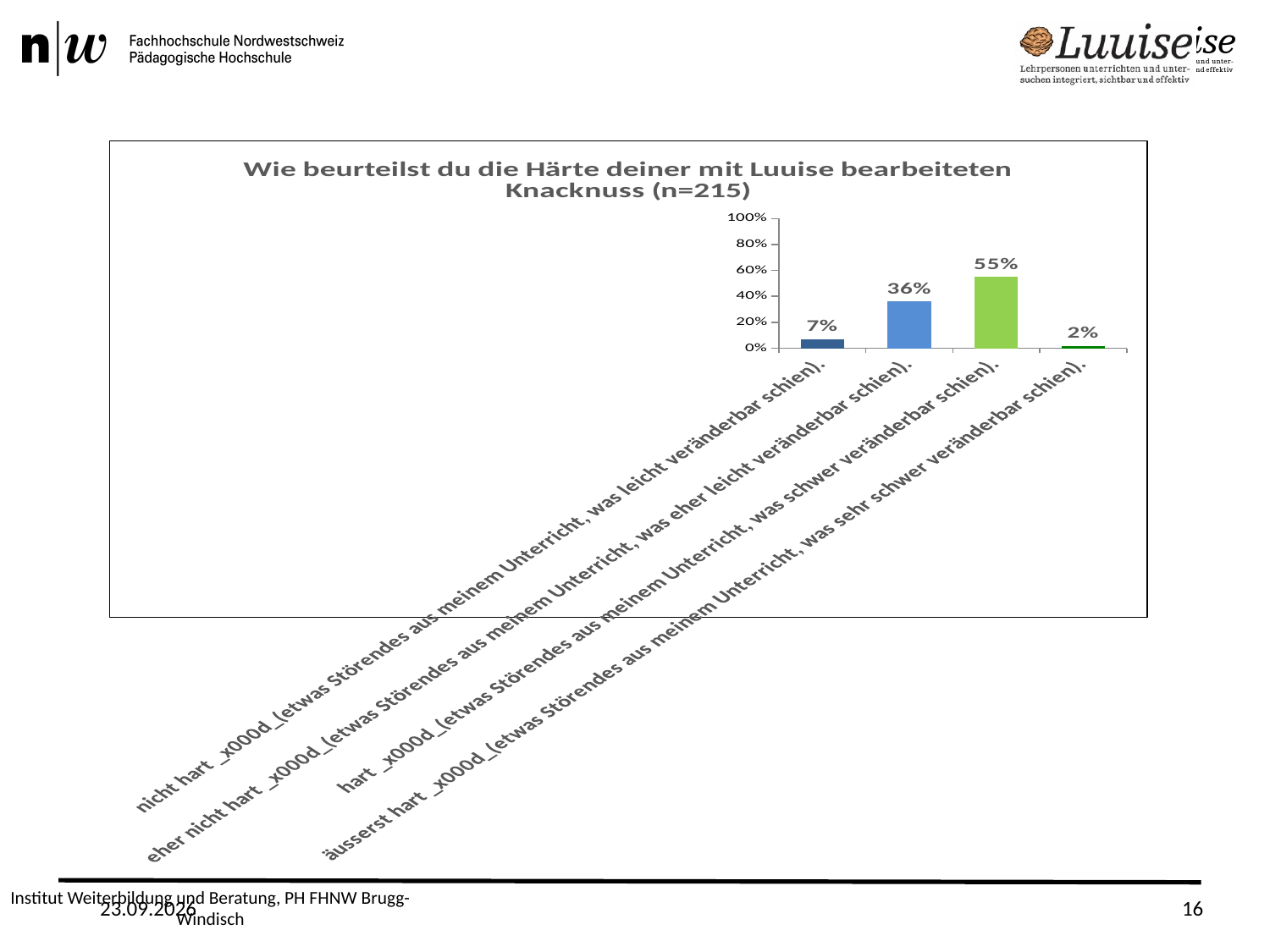
What value is shown for the "äusserst hart" category? 2% Which category has the highest value? hart What sample size (n) is given in the chart title? n=215 Is the value for "eher nicht hart" greater or less than 20%? greater Which category has the lowest value? äusserst hart How many categories are shown in the chart? 4 What value is shown for the "hart" category? 55% What value is shown for the "nicht hart" category? 7% Which is larger, the value for "nicht hart" or the value for "äusserst hart"? nicht hart What is the difference between the values for "hart" and "eher nicht hart"? 19% What value is shown for the "eher nicht hart" category? 36% What kind of chart is shown on the slide? bar chart